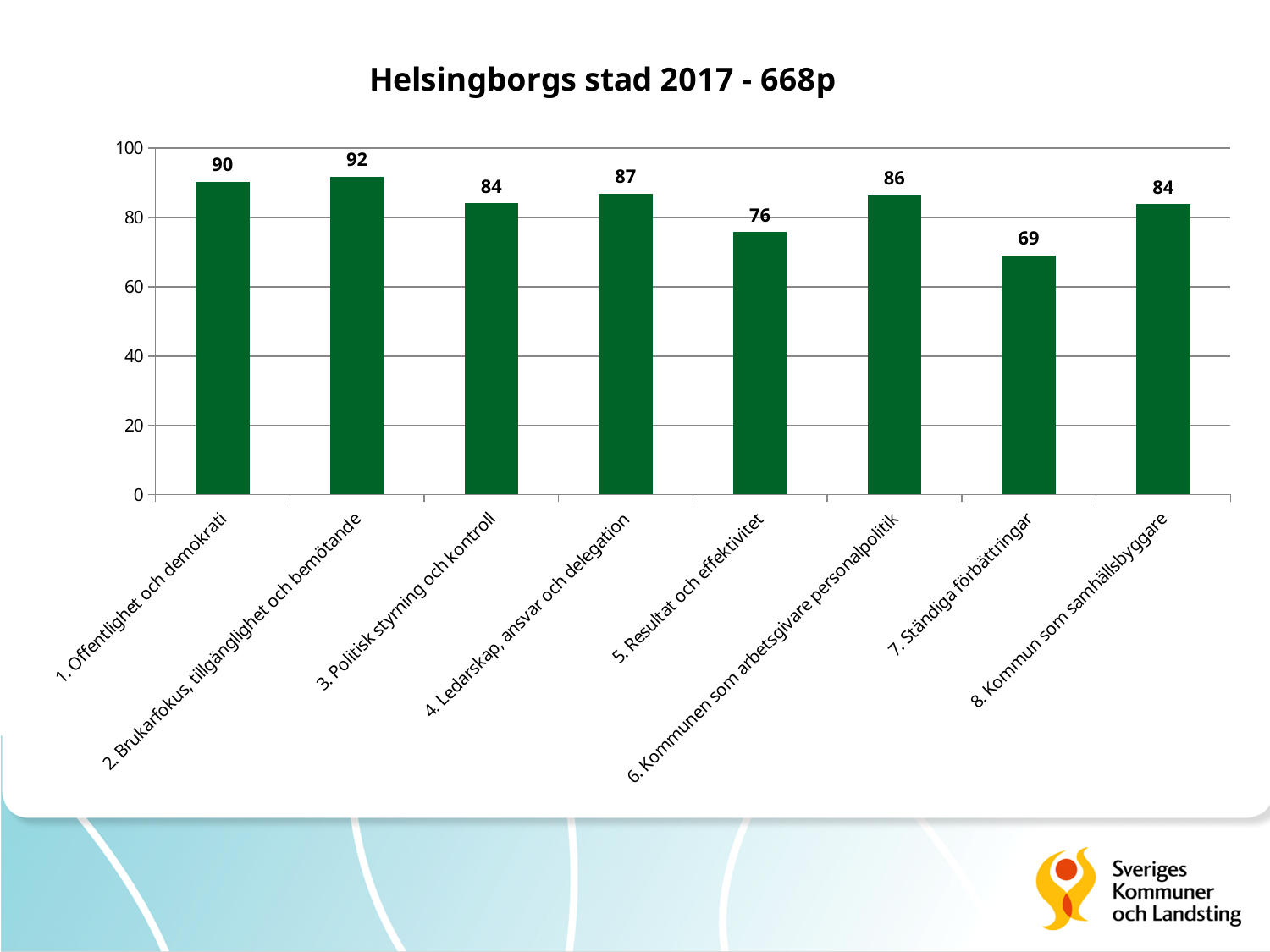
What colour are the bars in the chart? green What is the value for "2. Brukarfokus, tillgänglighet och bemötande"? 92 What kind of chart is shown on the slide? bar chart What is the difference between the values for "1. Offentlighet och demokrati" and "7. Ständiga förbättringar"? 21 How many categories are shown on the chart? 8 Which is larger, the value for "4. Ledarskap, ansvar och delegation" or the value for "6. Kommunen som arbetsgivare personalpolitik"? 4. Ledarskap, ansvar och delegation Which category has the highest value? 2. Brukarfokus, tillgänglighet och bemötande Is the value for "5. Resultat och effektivitet" greater or less than 80? less Which category has the lowest value? 7. Ständiga förbättringar What is the value for "5. Resultat och effektivitet"? 76 What is the title of the chart? Helsingborgs stad 2017 - 668p What is the value for "7. Ständiga förbättringar"? 69